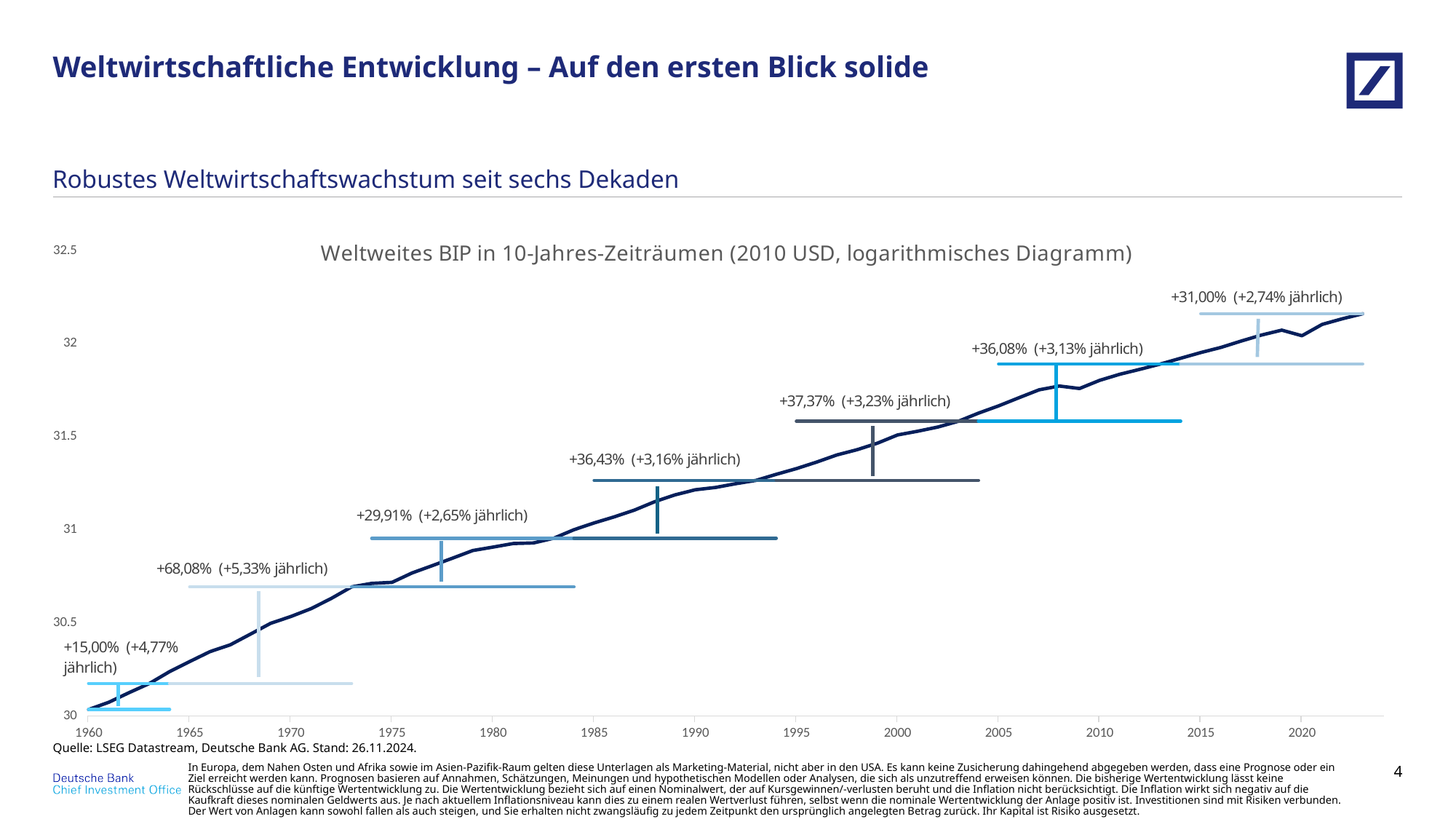
What annual growth rate is annotated for the period with +68,08% total growth? +5,33% jährlich What total growth is annotated for the 10-year period starting in 1960? +15,00% What is the title of the chart? Weltweites BIP in 10-Jahres-Zeiträumen (2010 USD, logarithmisches Diagramm) What total growth is annotated for the period with +2,65% annual growth? +29,91% Does the plotted world GDP line rise or fall from 1960 to the 2020s? rise What kind of chart is shown on the slide? line chart Which annotated 10-year period has the highest total growth? +68,08% (+5,33% jährlich) What annual growth rate is annotated for the most recent 10-year period (+31,00%)? +2,74% jährlich Is the plotted value for 2020 greater or less than 31.5? greater Which annotated 10-year period has the lowest total growth? +15,00% (+4,77% jährlich) How many 10-year growth periods are annotated on the chart? 7 Is the annotated total growth of +37,37% larger or smaller than the +36,08% growth? larger